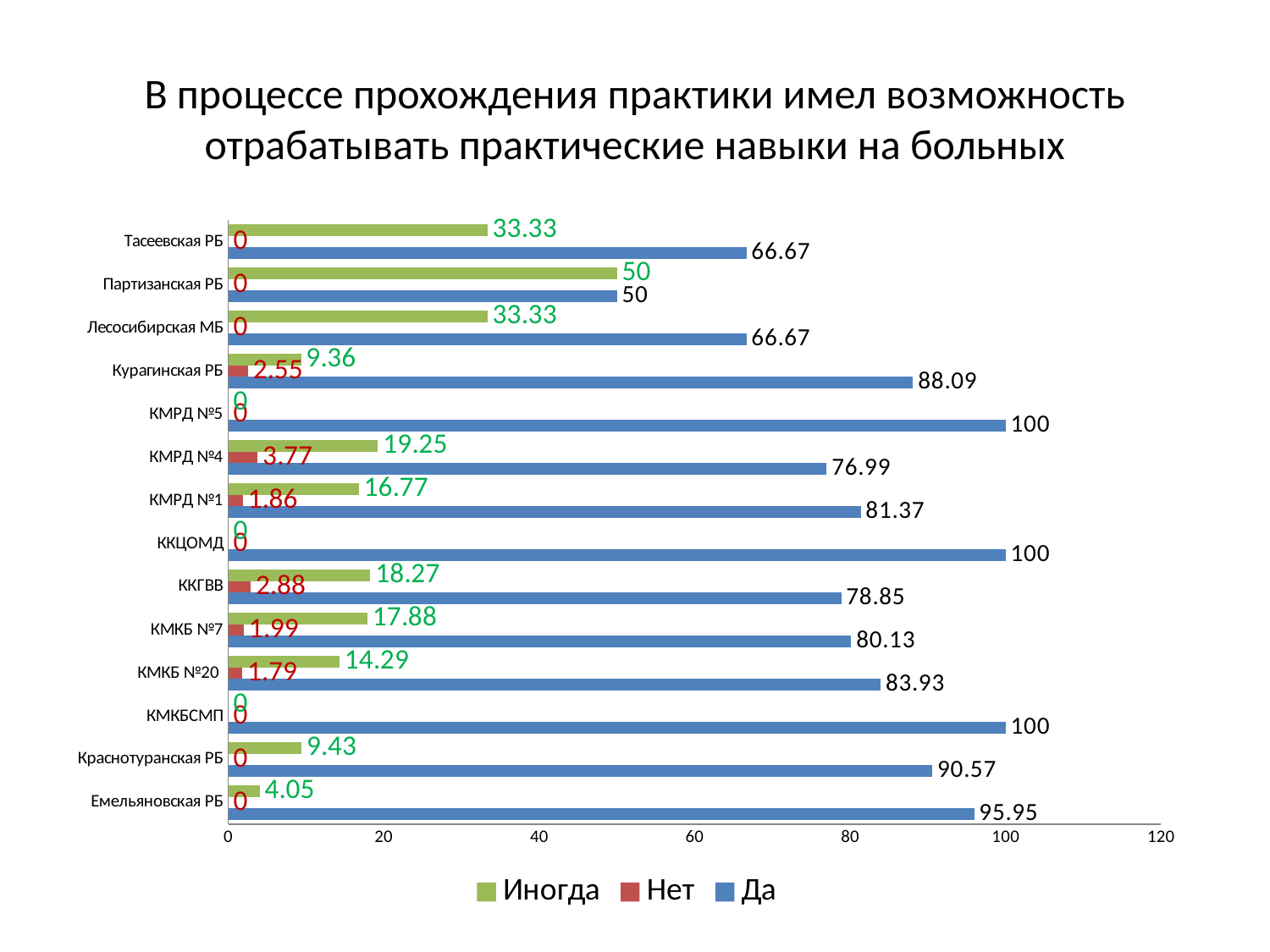
How many categories (institutions) are shown on the chart? 14 What is the value of the "Иногда" series for КМРД №4? 19.25 What is the value of the "Да" series for Курагинская РБ? 88.09 Which is larger: the "Иногда" value for КМКБ №7 or for КМКБ №20? КМКБ №7 What kind of chart is shown on the slide? Bar chart What is the difference between the "Да" values for Емельяновская РБ and Краснотуранская РБ? 5.38 How many series does the legend list? 3 What is the value of the "Нет" series for ККГВВ? 2.88 Is the "Да" value for КМРД №1 greater or less than 80? greater Which category has the highest value in the "Нет" series? КМРД №4 Which category has the lowest value in the "Да" series? Партизанская РБ Which colour represents the "Да" series in the legend? Blue